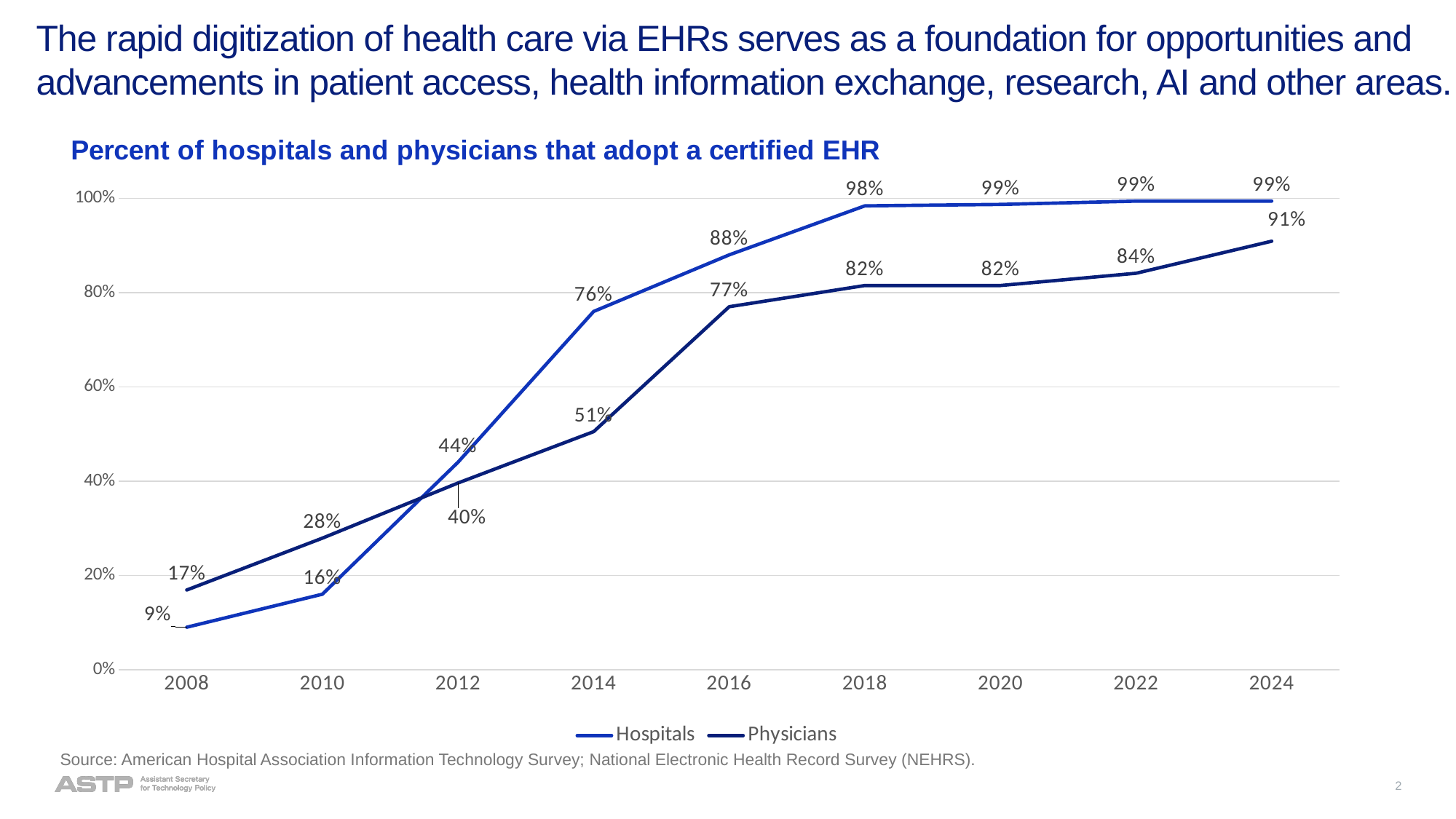
What percent of hospitals had adopted a certified EHR in 2008? 9% What is the value for Hospitals in 2014? 76% What is the value for Physicians in 2012? 40% How many series does the legend list? 2 Which series has the higher value in 2010, Hospitals or Physicians? Physicians What percent of physicians had adopted a certified EHR in 2024? 91% How many years are shown on the x axis? 9 In which year is the Physicians value lowest? 2008 Does the Hospitals series rise or fall from 2008 to 2018? Rise What is the difference between the Hospitals and Physicians values in 2016? 11% Which series has the higher value in 2018, Hospitals or Physicians? Hospitals What kind of chart is shown on the slide? Line chart